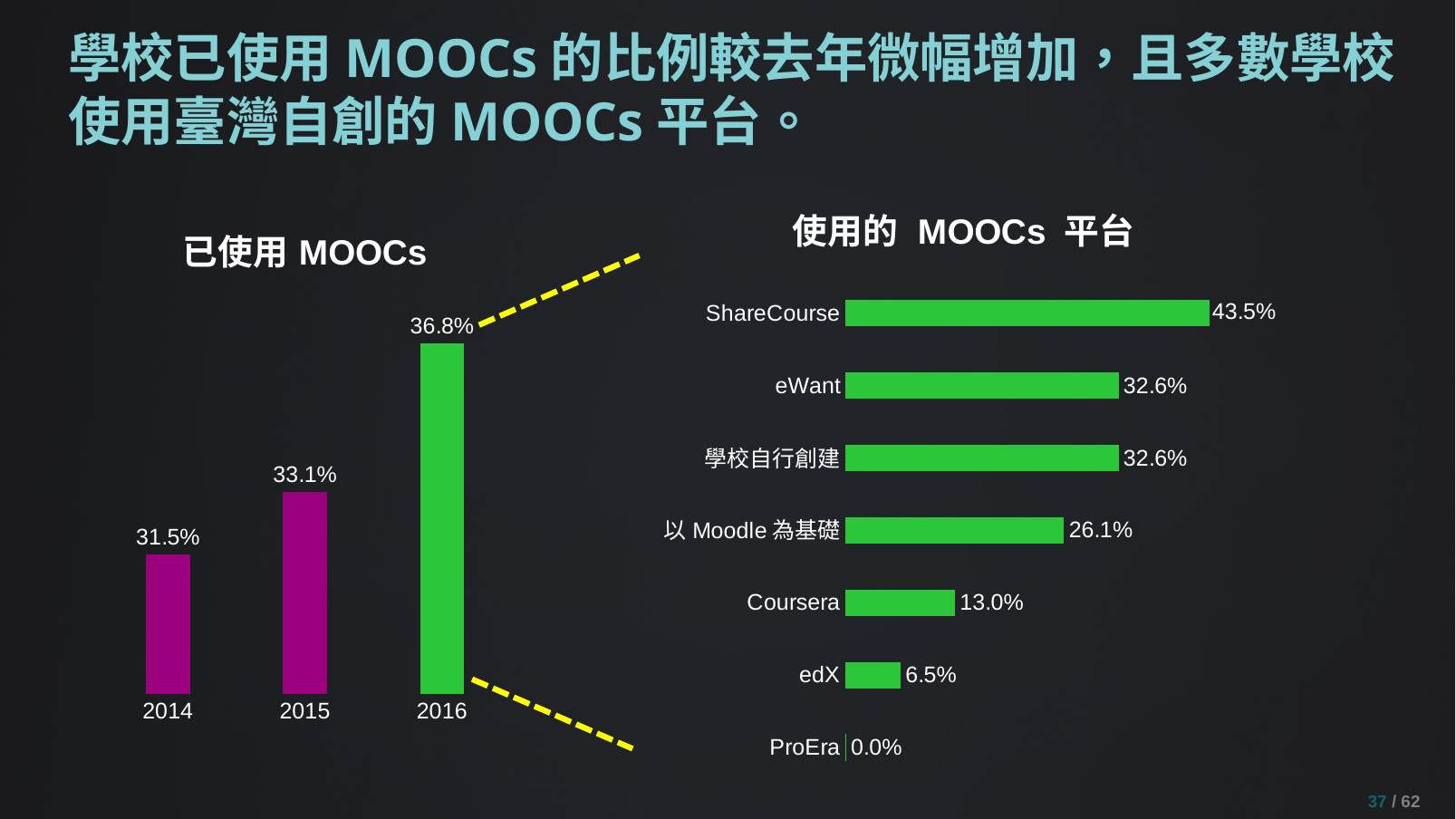
In the '已使用 MOOCs' chart, what is the difference between the 2016 and 2015 values? 3.7% In the '已使用 MOOCs' chart, how many years are shown? 3 In the '使用的 MOOCs 平台' chart, what is the value for ShareCourse? 43.5% In the '已使用 MOOCs' chart, which year has the highest value? 2016 In the '使用的 MOOCs 平台' chart, which platform has the lowest value? ProEra In the '已使用 MOOCs' chart, do the values rise or fall from 2014 to 2016? rise In the '已使用 MOOCs' chart, what is the value for 2014? 31.5% What kind of chart is the '使用的 MOOCs 平台' chart? bar chart In the '使用的 MOOCs 平台' chart, what is the value for Coursera? 13.0% In the '使用的 MOOCs 平台' chart, which is larger, the value for 以 Moodle 為基礎 or the value for edX? 以 Moodle 為基礎 In the '使用的 MOOCs 平台' chart, how many platforms are listed? 7 In the '已使用 MOOCs' chart, what is the value for 2016? 36.8%